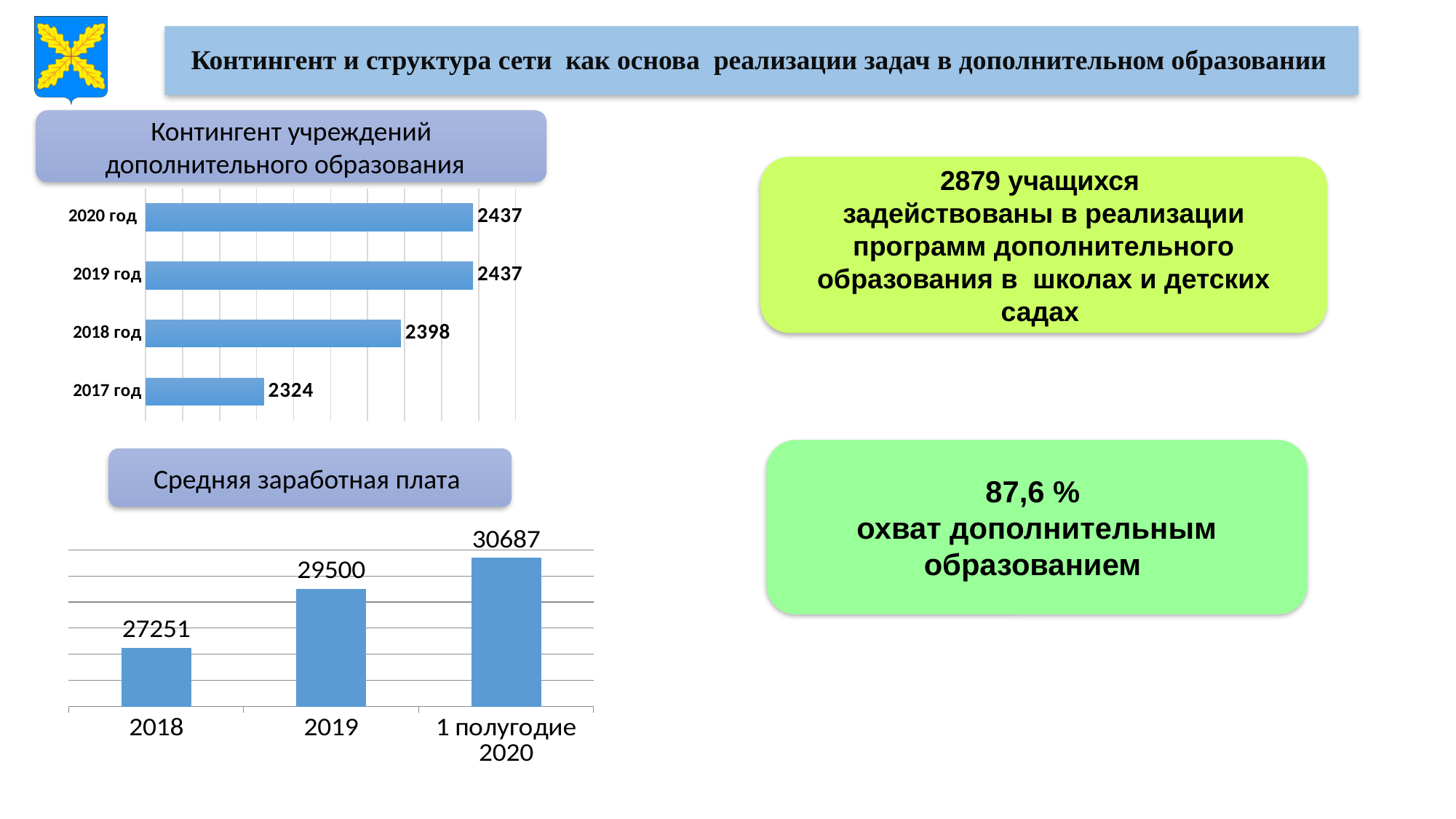
In the 'Средняя заработная плата' chart, how many bars are shown? 3 In the 'Средняя заработная плата' chart, which category has the highest value? 1 полугодие 2020 In the 'Средняя заработная плата' chart, what is the difference between the values for 2019 and 2018? 2249 What type of chart is the 'Контингент учреждений дополнительного образования' chart? Bar chart In the 'Средняя заработная плата' chart, do the values rise or fall from 2018 to 1 полугодие 2020? Rise In the 'Средняя заработная плата' chart, what is the value for 1 полугодие 2020? 30687 In the 'Контингент учреждений дополнительного образования' chart, what is the difference between the values for 2018 год and 2017 год? 74 In the 'Контингент учреждений дополнительного образования' chart, what is the value for 2018 год? 2398 In the 'Контингент учреждений дополнительного образования' chart, what is the value for 2017 год? 2324 In the 'Средняя заработная плата' chart, what is the value for 2019? 29500 In the 'Контингент учреждений дополнительного образования' chart, which year has the lowest value? 2017 год In the 'Контингент учреждений дополнительного образования' chart, how many years are shown? 4